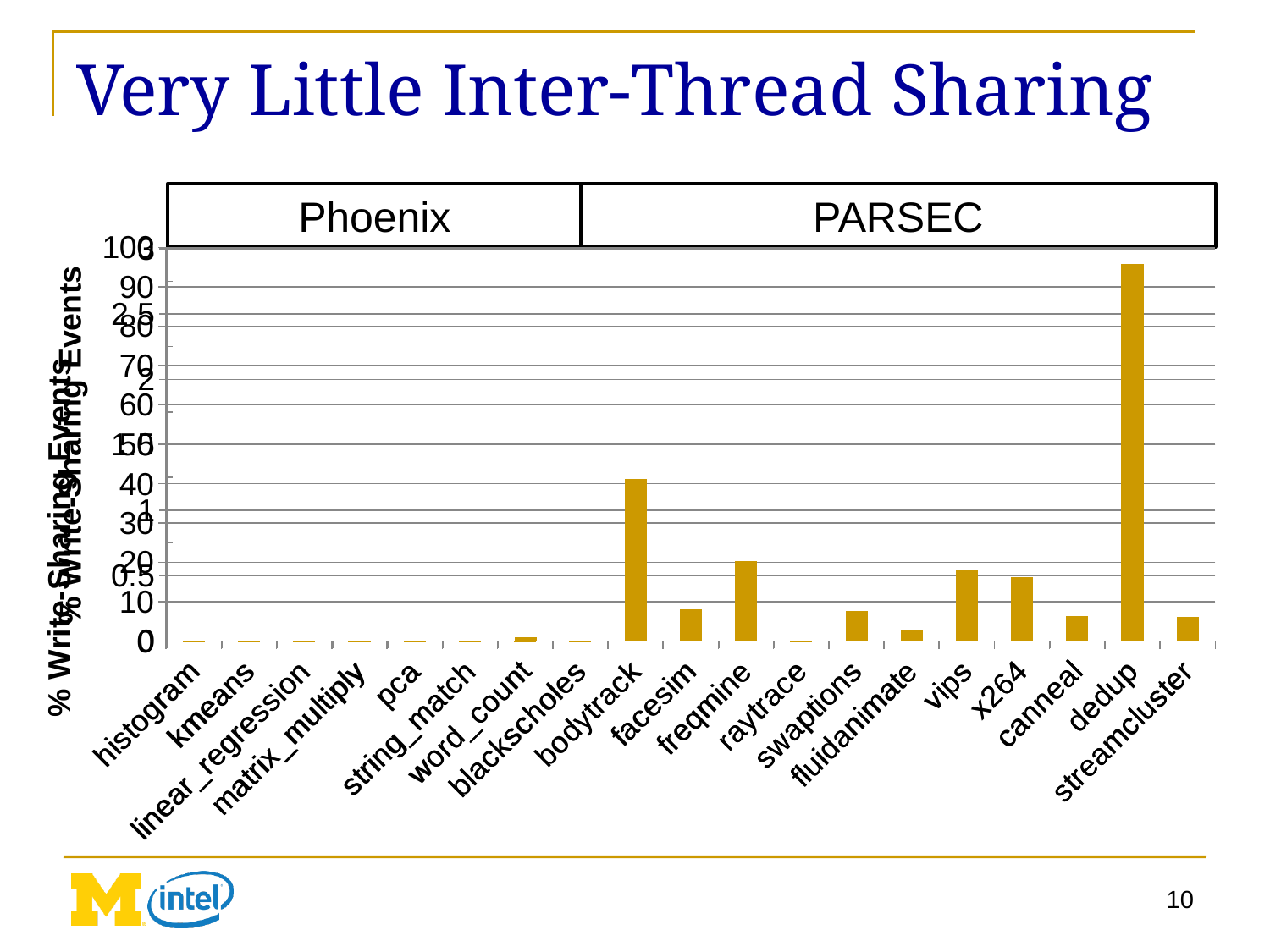
What kind of chart is shown on the slide? bar chart Is the value for x264 greater or less than 20? less Is the value for facesim greater or less than 10? less Which benchmark has the highest value? dedup Is the value for fluidanimate greater or less than 10? less Which is larger, the value for bodytrack or the value for freqmine? bodytrack What are the two benchmark suite groups labelled above the chart? Phoenix and PARSEC Which is larger, the value for vips or the value for facesim? vips How many benchmark categories are plotted along the x axis? 19